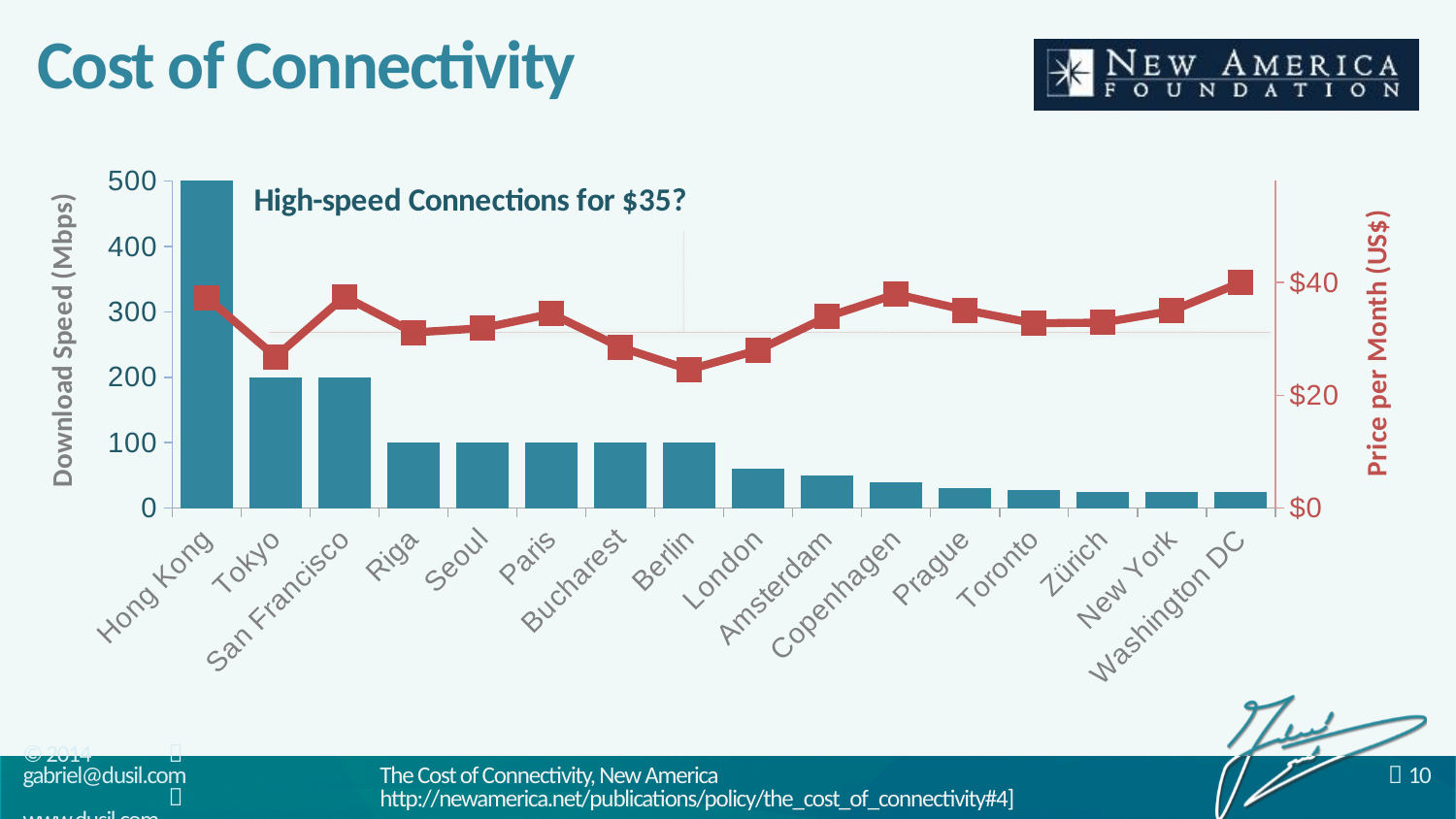
What is the download speed shown for Hong Kong? 500 Mbps What is the download speed shown for Tokyo? 200 Mbps What kind of chart is shown on the slide? A bar chart combined with a line chart Which has the higher download speed, Hong Kong or San Francisco? Hong Kong How many cities are shown along the x axis of the chart? 16 What is the difference in download speed between Hong Kong and Tokyo? 300 Mbps What is the title of the chart? High-speed Connections for $35? Do the download speed bars rise or fall from left to right along the x axis? fall Is the price per month for Washington DC greater or less than $20? greater Is the download speed for London greater or less than 100 Mbps? less Which city has the lowest price per month on the line? Berlin Which city has the highest download speed bar? Hong Kong